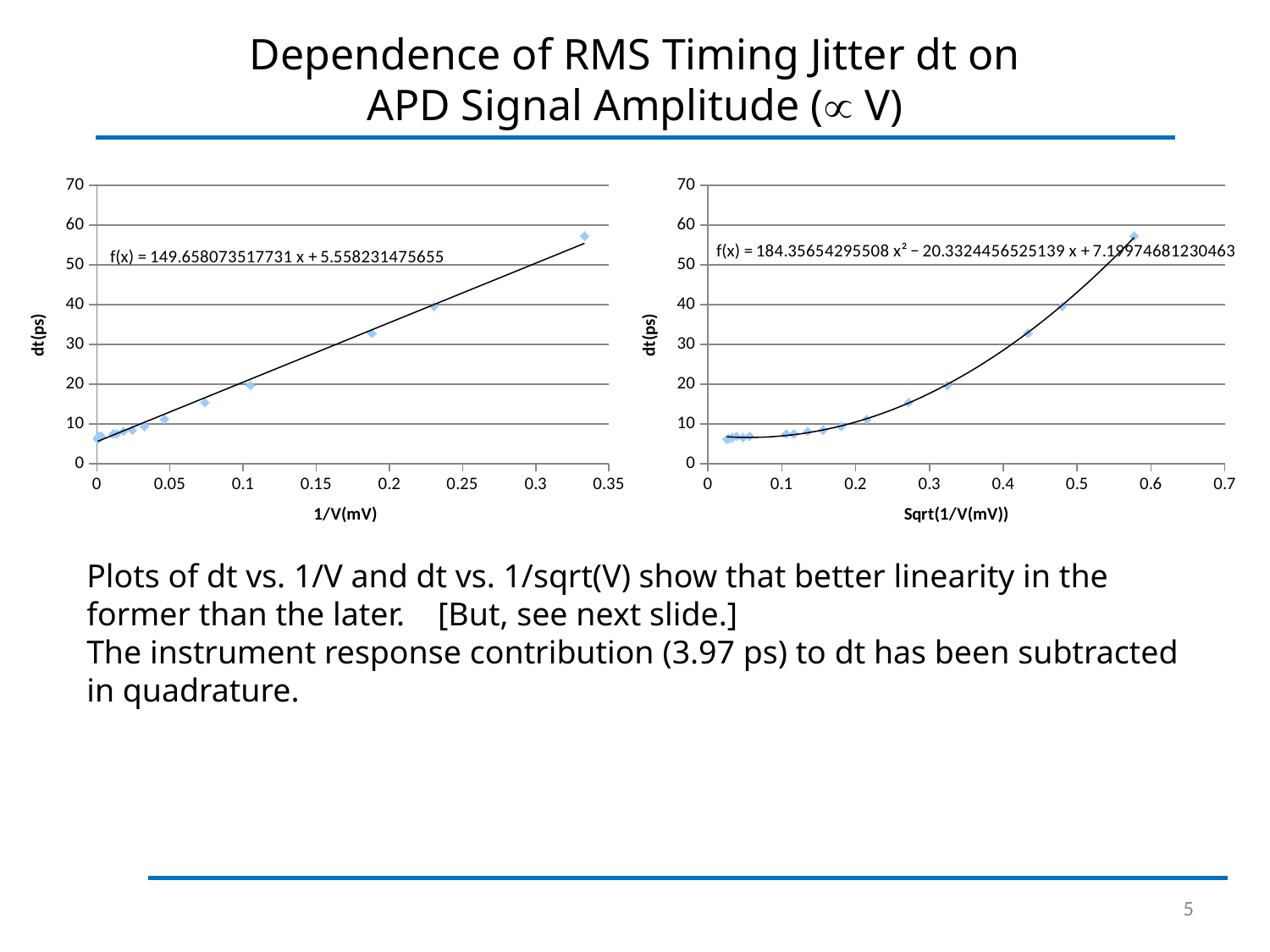
What is the slope shown in the fitted line equation on the left chart? 149.658073517731 In the left chart, is the dt(ps) value of the data point near 1/V = 0.19 greater or less than 30? greater In the left chart, is the dt(ps) value of the rightmost data point (near 1/V = 0.33) greater or less than 50? greater In the right chart, do the dt(ps) values rise or fall as Sqrt(1/V(mV)) increases? rise What kind of chart is the left chart (dt vs 1/V(mV))? scatter chart What is the x-axis title of the right chart? Sqrt(1/V(mV)) In the right chart, is the dt(ps) value of the data point near Sqrt(1/V) = 0.27 greater or less than 20? less In the left chart, do the dt(ps) values rise or fall as 1/V(mV) increases? rise What kind of chart is the right chart (dt vs Sqrt(1/V(mV)))? scatter chart